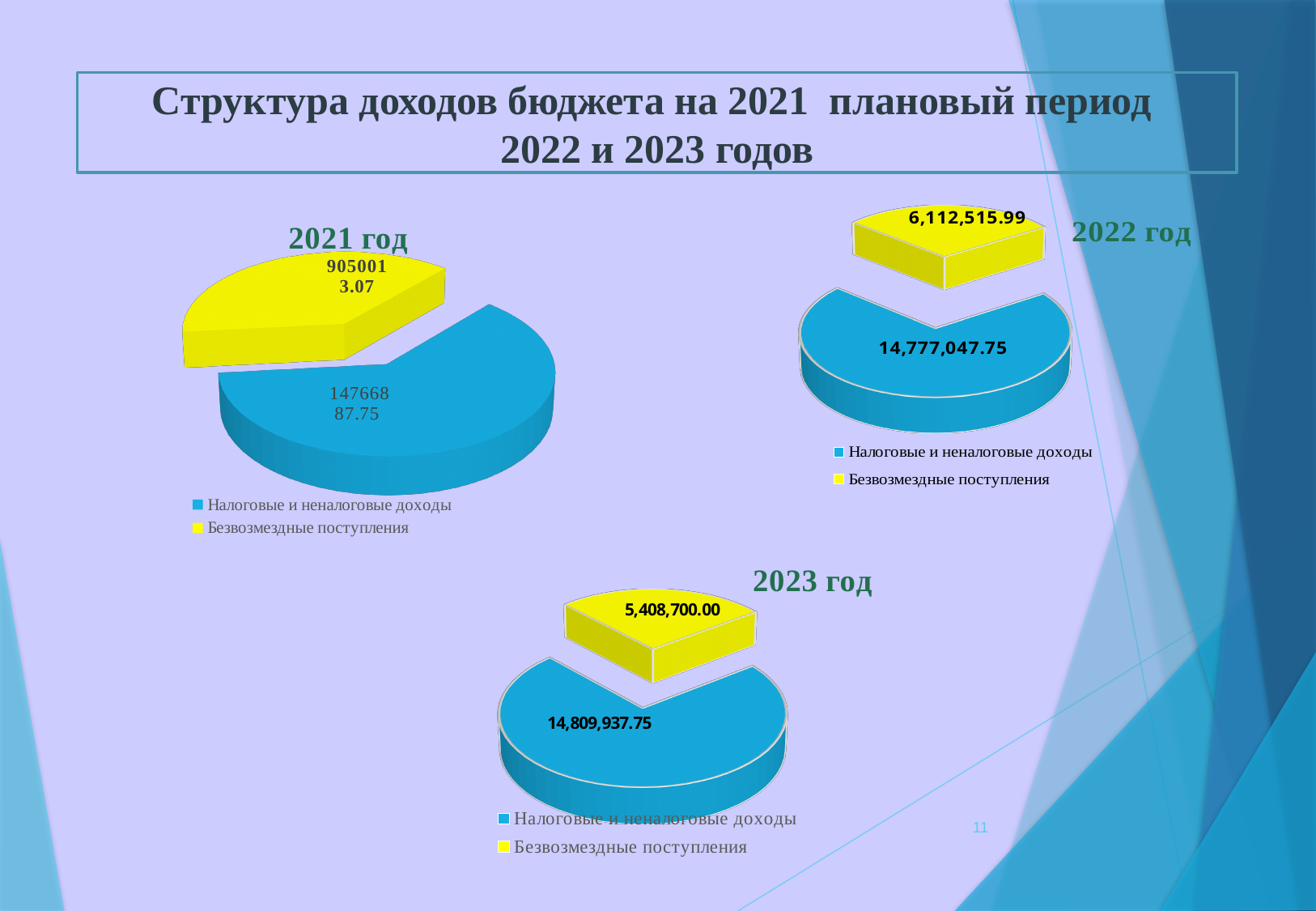
What type of chart is used for the 2021 год chart? pie chart In the 2023 год chart, which is larger: Налоговые и неналоговые доходы or Безвозмездные поступления? Налоговые и неналоговые доходы In the 2022 год chart, what colour is the slice for Безвозмездные поступления? yellow In the 2021 год chart, which category has the smallest slice? Безвозмездные поступления In the 2023 год chart, what is the value for Безвозмездные поступления? 5,408,700.00 In the 2022 год chart, what is the value for Налоговые и неналоговые доходы? 14,777,047.75 In the 2022 год chart, which category has the largest slice? Налоговые и неналоговые доходы In the 2022 год chart, what is the value for Безвозмездные поступления? 6,112,515.99 In the 2023 год chart, what is the value for Налоговые и неналоговые доходы? 14,809,937.75 How many series does the legend of the 2023 год chart list? 2 How many charts are shown on the slide? 3 In the 2022 год chart, what is the difference between Налоговые и неналоговые доходы and Безвозмездные поступления? 8,664,531.76